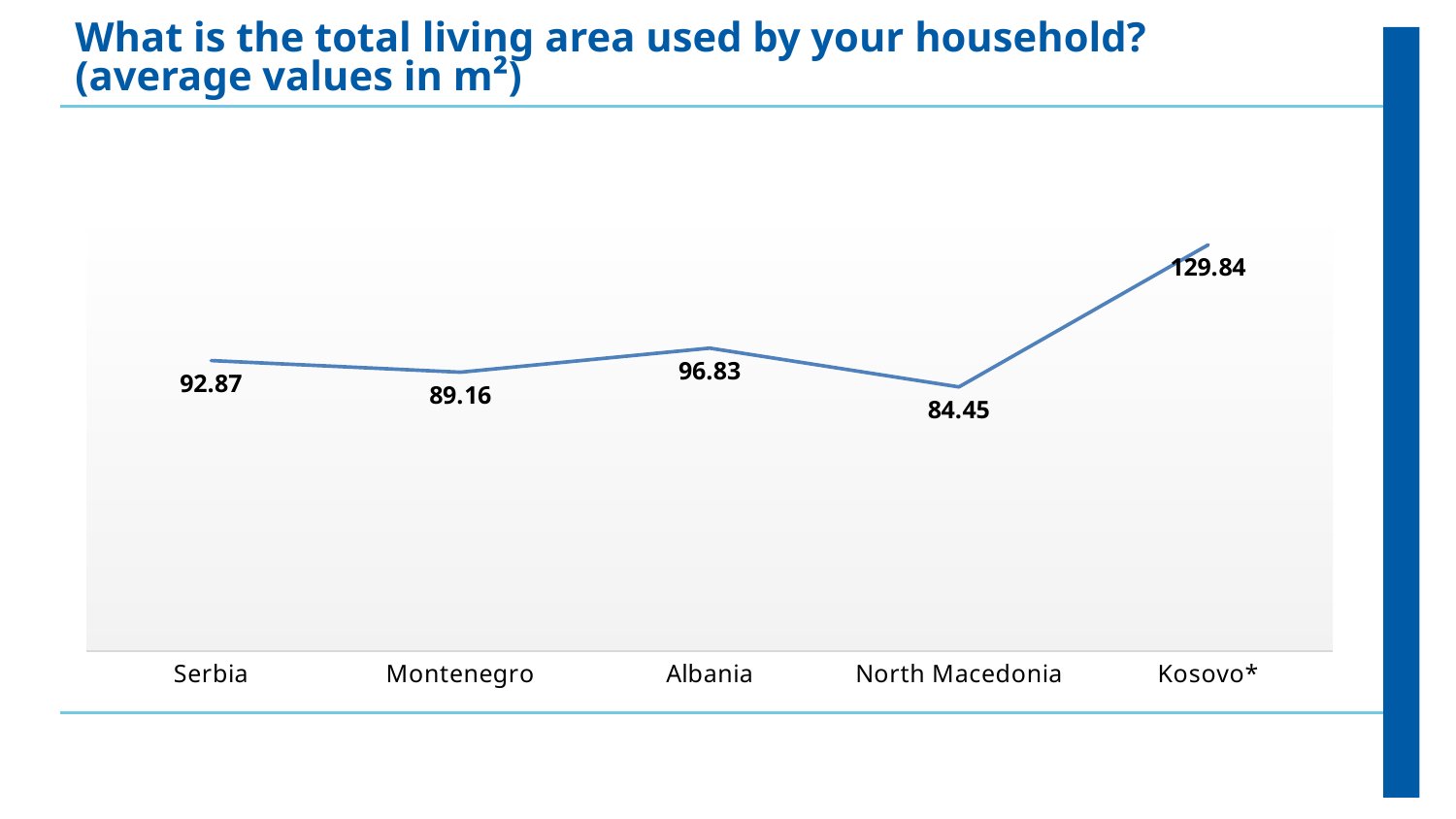
What is the average living area for Kosovo*? 129.84 Which has a larger value, Serbia or Montenegro? Serbia What is the average living area for North Macedonia? 84.45 What is the average living area for Montenegro? 89.16 What is the difference between the values for Kosovo* and North Macedonia? 45.39 What is the average living area for Albania? 96.83 What is the difference between the values for Albania and Montenegro? 7.67 Which country has the lowest average living area? North Macedonia Which country has the highest average living area? Kosovo* What kind of chart is shown on the slide? Line chart How many countries are shown on the chart? 5 What is the average living area for Serbia? 92.87